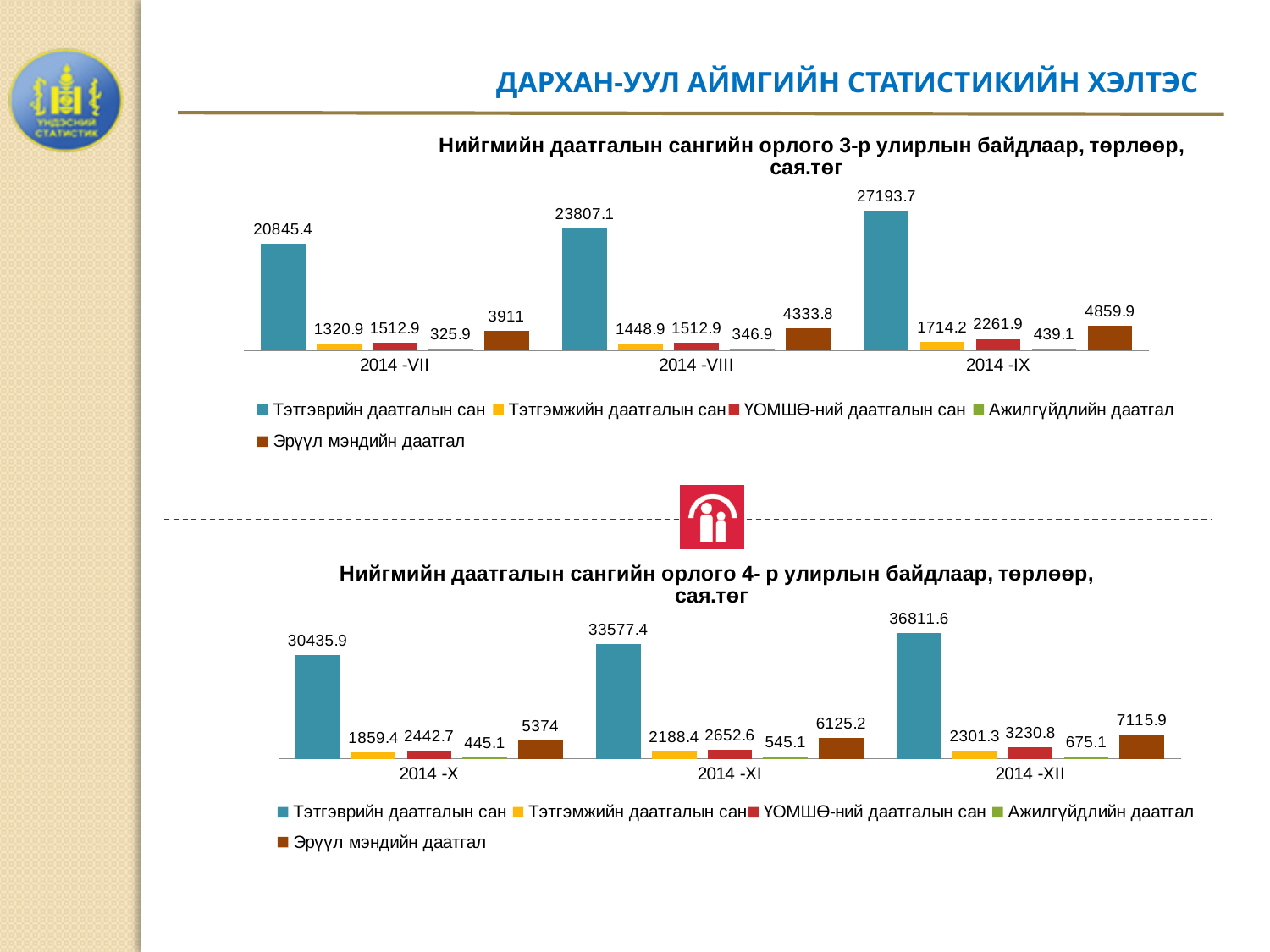
In the top chart (3-р улирал), does the value of Ажилгүйдлийн даатгал rise or fall from 2014 -VII to 2014 -IX? rise In the bottom chart (4-р улирал), which is larger: Тэтгэмжийн даатгалын сан or ҮОМШӨ-ний даатгалын сан for 2014 -XI? ҮОМШӨ-ний даатгалын сан In the top chart (3-р улирал), what is the value of Тэтгэврийн даатгалын сан for 2014 -VII? 20845.4 In the bottom chart (4-р улирал), what is the value of Тэтгэмжийн даатгалын сан for 2014 -X? 1859.4 In the bottom chart (4-р улирал), which month has the lowest value for Эрүүл мэндийн даатгал? 2014 -X What type of chart is the bottom chart (4-р улирал)? bar chart In the bottom chart (4-р улирал), what is the value of ҮОМШӨ-ний даатгалын сан for 2014 -XII? 3230.8 In the top chart (3-р улирал), what is the value of Эрүүл мэндийн даатгал for 2014 -IX? 4859.9 In the top chart (3-р улирал), how many series does the legend list? 5 In the top chart (3-р улирал), what is the difference between the Тэтгэврийн даатгалын сан values for 2014 -IX and 2014 -VIII? 3386.6 In the bottom chart (4-р улирал), how many months are shown on the x axis? 3 In the top chart (3-р улирал), which month has the highest value for Тэтгэврийн даатгалын сан? 2014 -IX